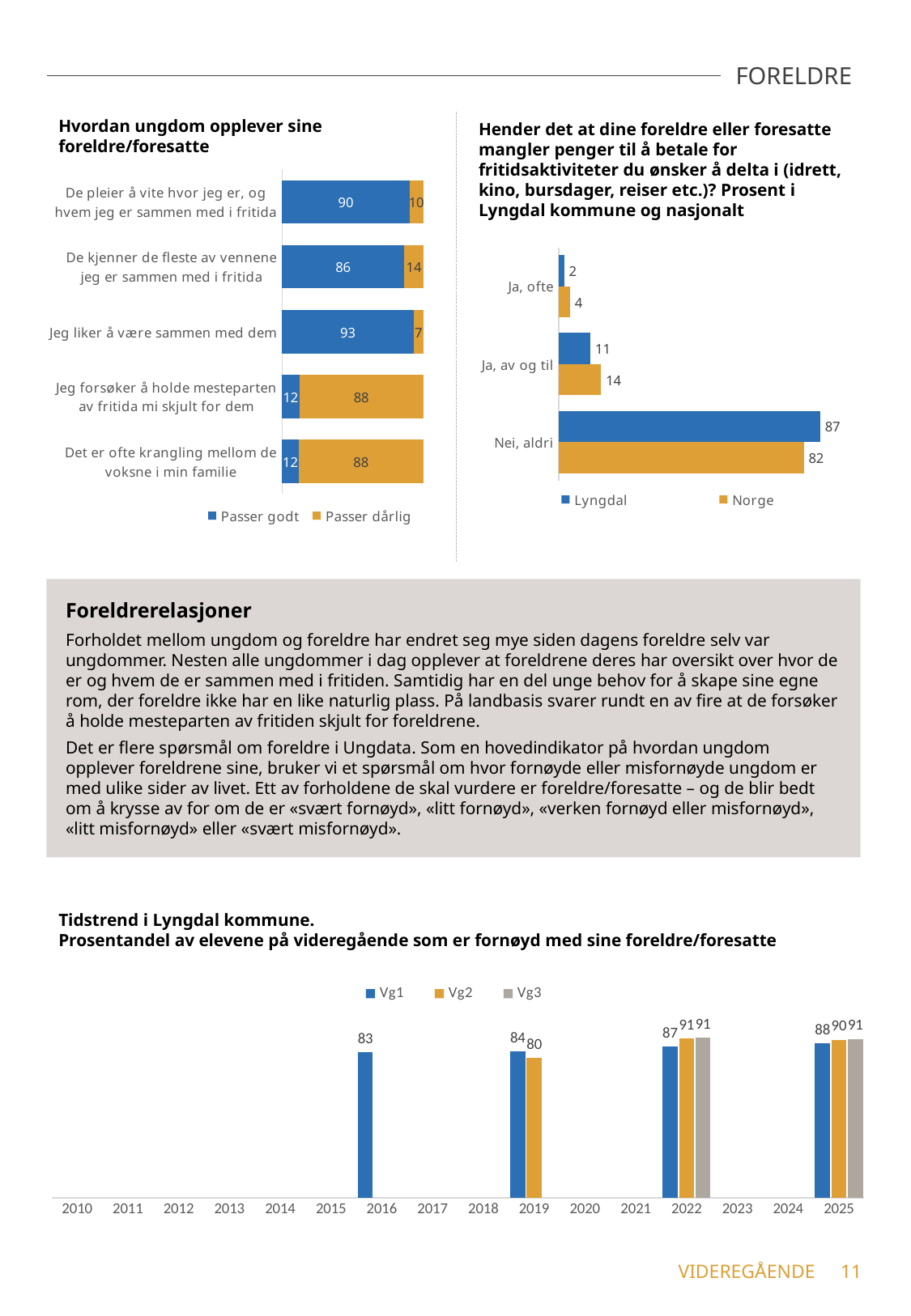
In the chart 'Hvordan ungdom opplever sine foreldre/foresatte', which category has the highest 'Passer dårlig' value? Jeg forsøker å holde mesteparten av fritida mi skjult for dem and Det er ofte krangling mellom de voksne i min familie (both 88) In the chart 'Hender det at dine foreldre eller foresatte mangler penger...', how many series does the legend list? 2 In the chart 'Tidstrend i Lyngdal kommune', what is the Vg2 value for 2019? 80 In the chart 'Hvordan ungdom opplever sine foreldre/foresatte', how many categories are shown? 5 In the chart 'Hender det at dine foreldre eller foresatte mangler penger...', what is the value for Norge for 'Ja, av og til'? 14 In the chart 'Hvordan ungdom opplever sine foreldre/foresatte', what is the 'Passer godt' value for 'Jeg liker å være sammen med dem'? 93 In the chart 'Tidstrend i Lyngdal kommune', what is the difference between the Vg3 and Vg1 values in 2025? 3 In the chart 'Hvordan ungdom opplever sine foreldre/foresatte', what is the total of the stacked bar for 'De kjenner de fleste av vennene jeg er sammen med i fritida'? 100 In the chart 'Hender det at dine foreldre eller foresatte mangler penger...', which is larger for 'Ja, ofte': Lyngdal or Norge? Norge In the chart 'Tidstrend i Lyngdal kommune', does the Vg1 value rise or fall from 2016 to 2025? Rise In the chart 'Hender det at dine foreldre eller foresatte mangler penger...', what is the difference between Lyngdal and Norge for 'Nei, aldri'? 5 In the chart 'Tidstrend i Lyngdal kommune', what kind of chart is shown? Bar chart